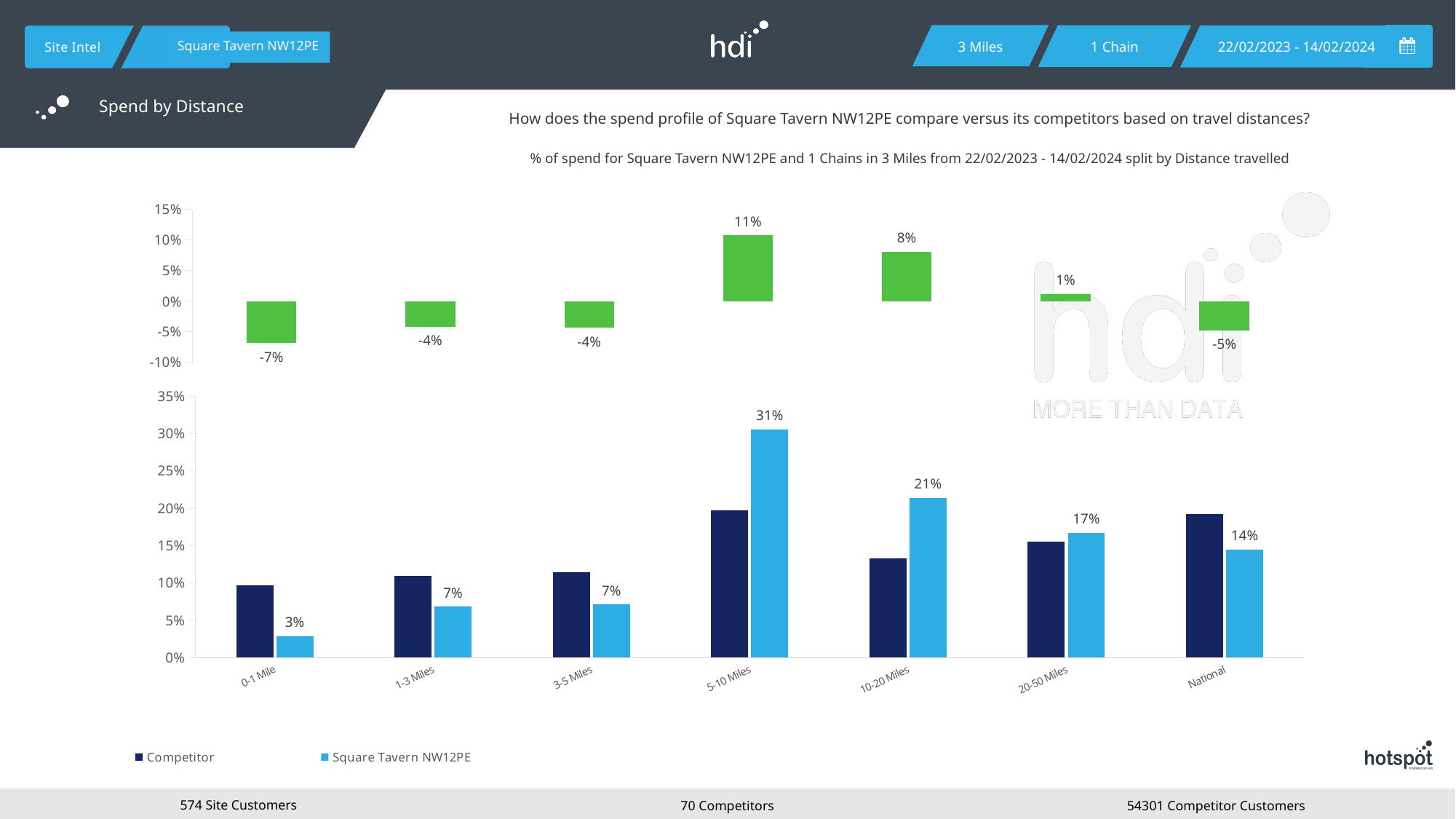
In the bottom chart, which distance band has the highest Square Tavern NW12PE value? 5-10 Miles In the bottom chart, at 0-1 Mile, which is larger: the Competitor bar or the Square Tavern NW12PE bar? Competitor In the bottom chart, what is the value for Square Tavern NW12PE at 5-10 Miles? 31% In the bottom chart, what is the difference between the Square Tavern NW12PE values at 5-10 Miles and 10-20 Miles? 10% In the bottom chart, which distance band has the lowest Square Tavern NW12PE value? 0-1 Mile In the top chart, what is the value of the fourth green bar from the left? 11% How many series does the legend of the bottom chart list? 2 In the bottom chart, what is the value for Square Tavern NW12PE for National? 14% In the bottom chart, is the Competitor value for National greater or less than 20%? less How many distance categories are shown on the x axis of the bottom chart? 7 In the bottom chart, is the Competitor value at 10-20 Miles greater or less than 10%? greater In the bottom chart, what is the value for Square Tavern NW12PE at 0-1 Mile? 3%